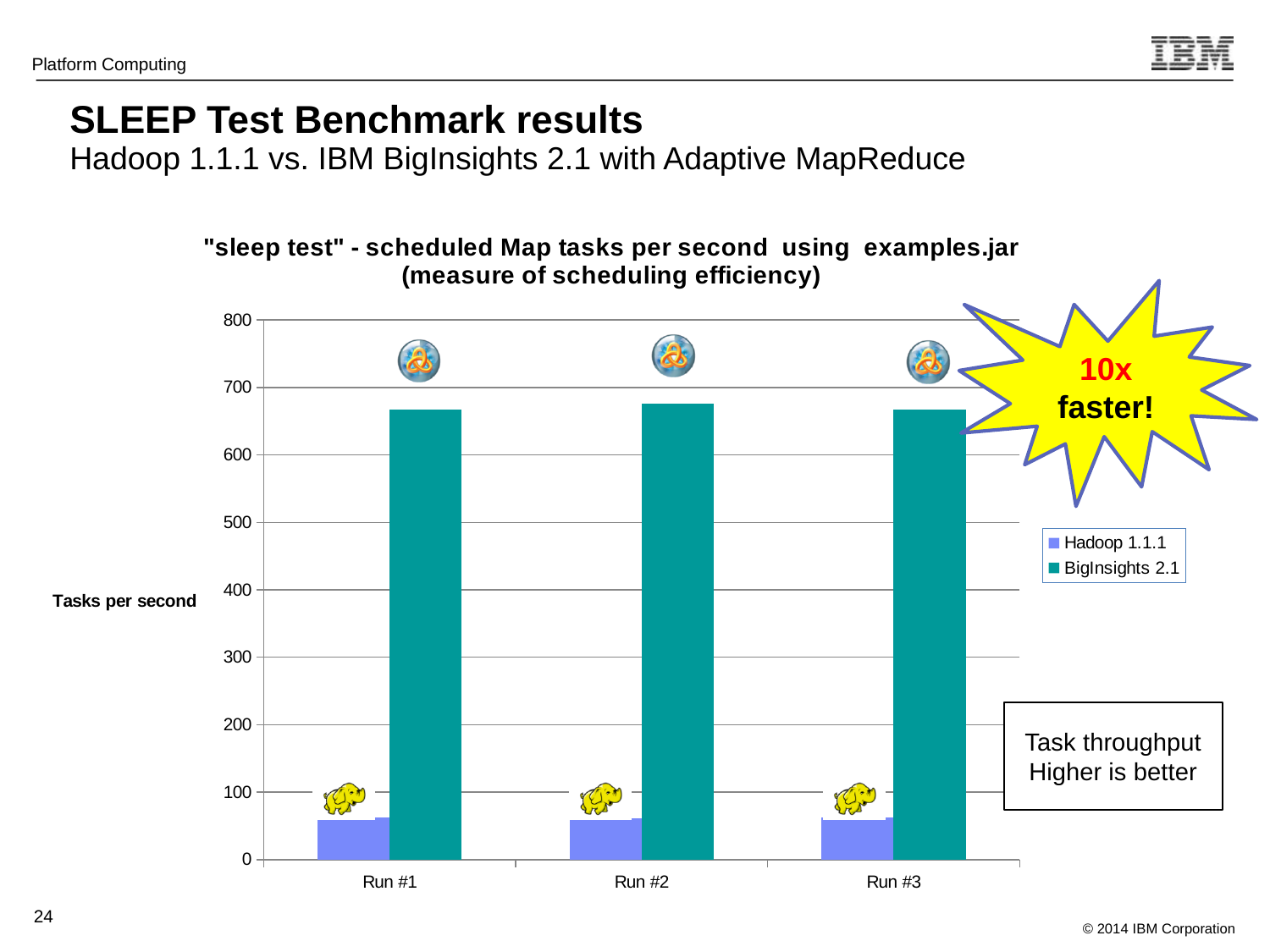
How many series does the chart legend list? 2 Is the value for BigInsights 2.1 in Run #3 greater or less than 700? less What is the highest tick value shown on the vertical axis of the chart? 800 Is the value for Hadoop 1.1.1 in Run #2 greater or less than 200? less What are the two series named in the chart legend? Hadoop 1.1.1 and BigInsights 2.1 Which series has the lower value for Run #3, Hadoop 1.1.1 or BigInsights 2.1? Hadoop 1.1.1 What kind of chart is shown on the slide? bar chart Is the value for BigInsights 2.1 in Run #2 greater or less than 600? greater Which series has the higher value for Run #1, Hadoop 1.1.1 or BigInsights 2.1? BigInsights 2.1 What is the label of the vertical axis of the chart? Tasks per second How many runs (categories) are shown on the x axis of the chart? 3